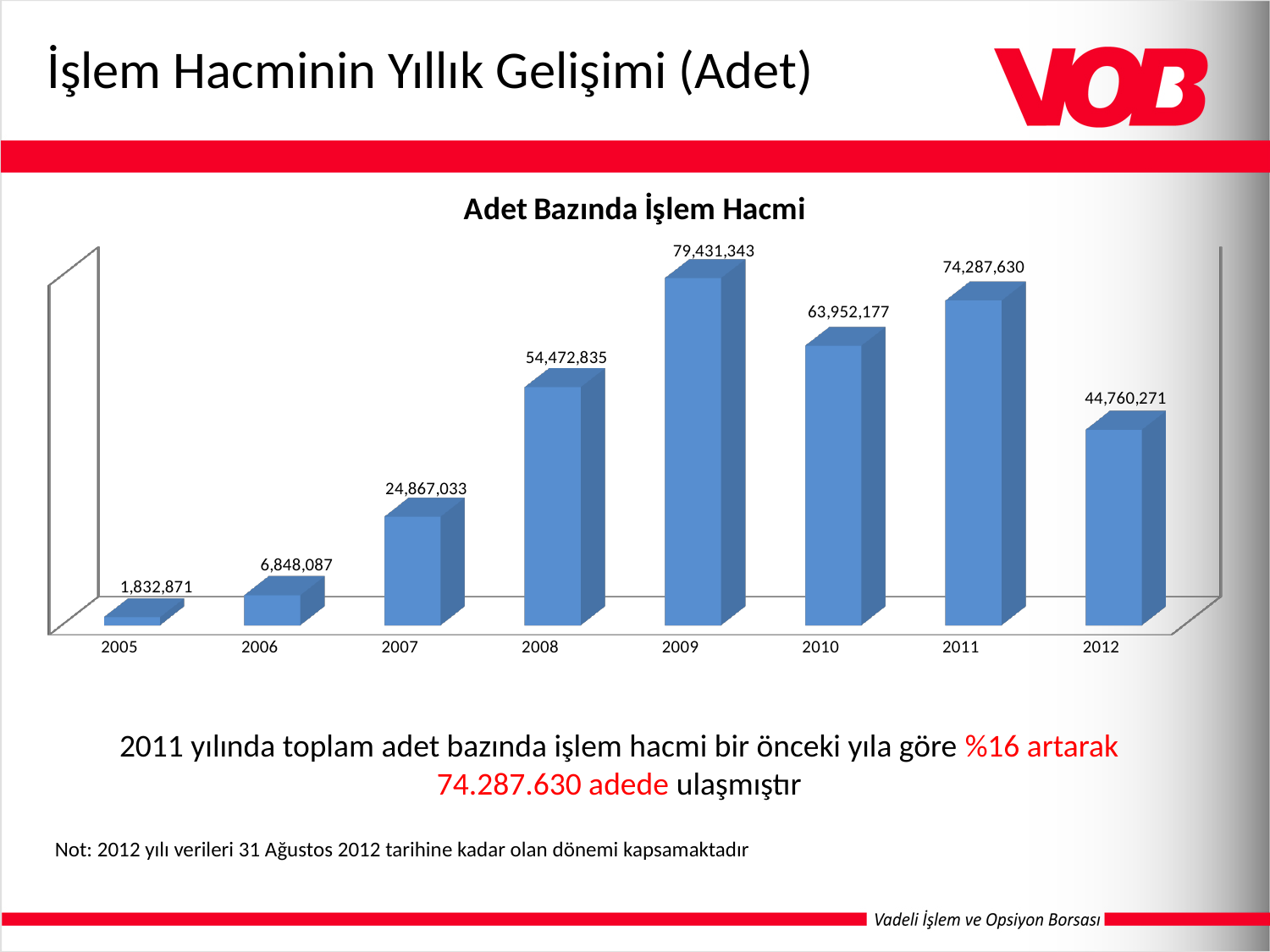
How many years are shown on the x axis of the chart? 8 Which year has the lowest value in the chart? 2005 What is the title of the chart? Adet Bazında İşlem Hacmi What is the difference between the values for 2009 and 2008? 24,958,508 Which year has the highest value in the chart? 2009 Which is larger, the value for 2010 or the value for 2012? 2010 What kind of chart is shown on the slide? Bar chart What is the difference between the values for 2011 and 2010? 10,335,453 What is the value for 2012 in the chart? 44,760,271 What is the value for 2007 in the chart? 24,867,033 What is the value for 2005 in the chart? 1,832,871 What is the value for 2009 in the chart? 79,431,343